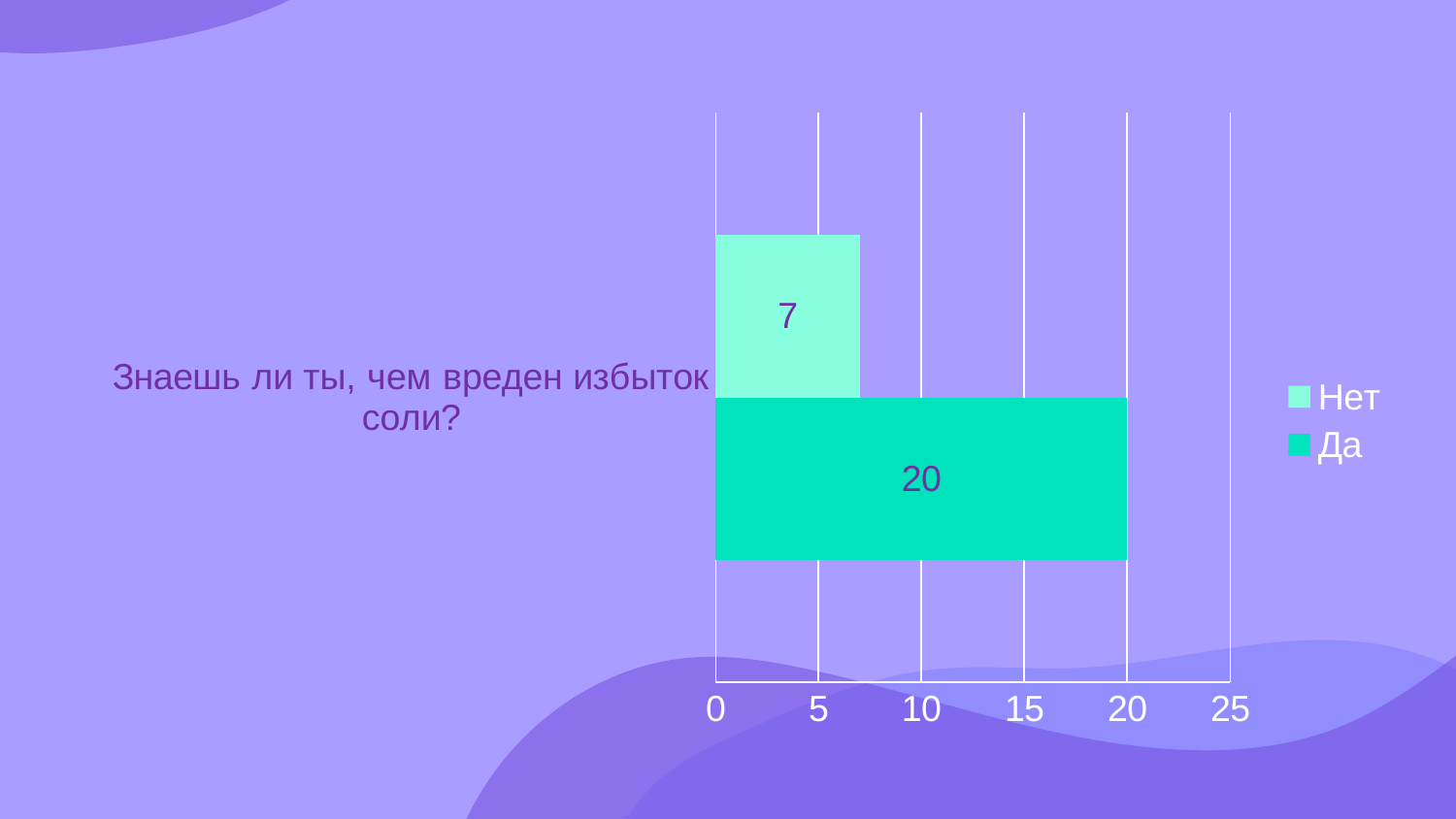
What is the difference between the values for "Да" and "Нет"? 13 Which series has the higher value, "Да" or "Нет"? Да How many series does the legend list? 2 What is the maximum value shown on the horizontal axis? 25 What is the value for "Нет"? 7 Which series has the highest value? Да Is the value for "Да" greater or less than 15? greater What is the title of the chart? Знаешь ли ты, чем вреден избыток соли? Is the value for "Нет" greater or less than 10? less What is the value for "Да"? 20 What kind of chart is shown on the slide? bar chart Which series has the lowest value? Нет